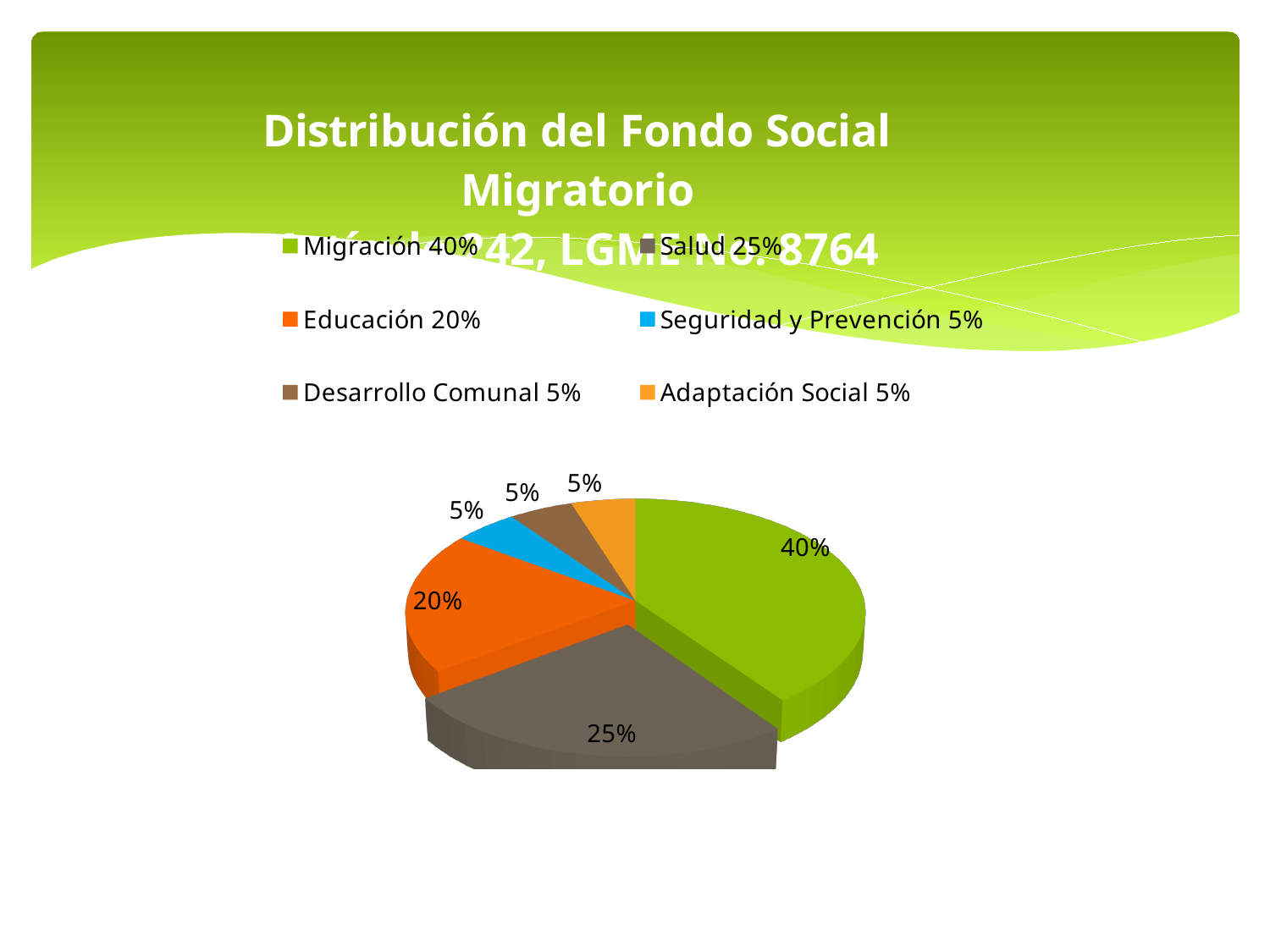
What share of the pie does Seguridad y Prevención represent? 5% What is the combined share of Seguridad y Prevención, Desarrollo Comunal and Adaptación Social? 15% Which is larger, the share for Salud or the share for Educación? Salud What type of chart is shown on the slide? pie chart How many entries does the legend list? 6 How many slices does the pie chart have? 6 What share of the pie does Educación represent? 20% What share of the pie does Salud represent? 25% What share of the pie does Migración represent? 40% Which category has the largest slice of the pie? Migración What colour is the slice for Educación? orange What is the difference between the shares of Migración and Salud? 15%